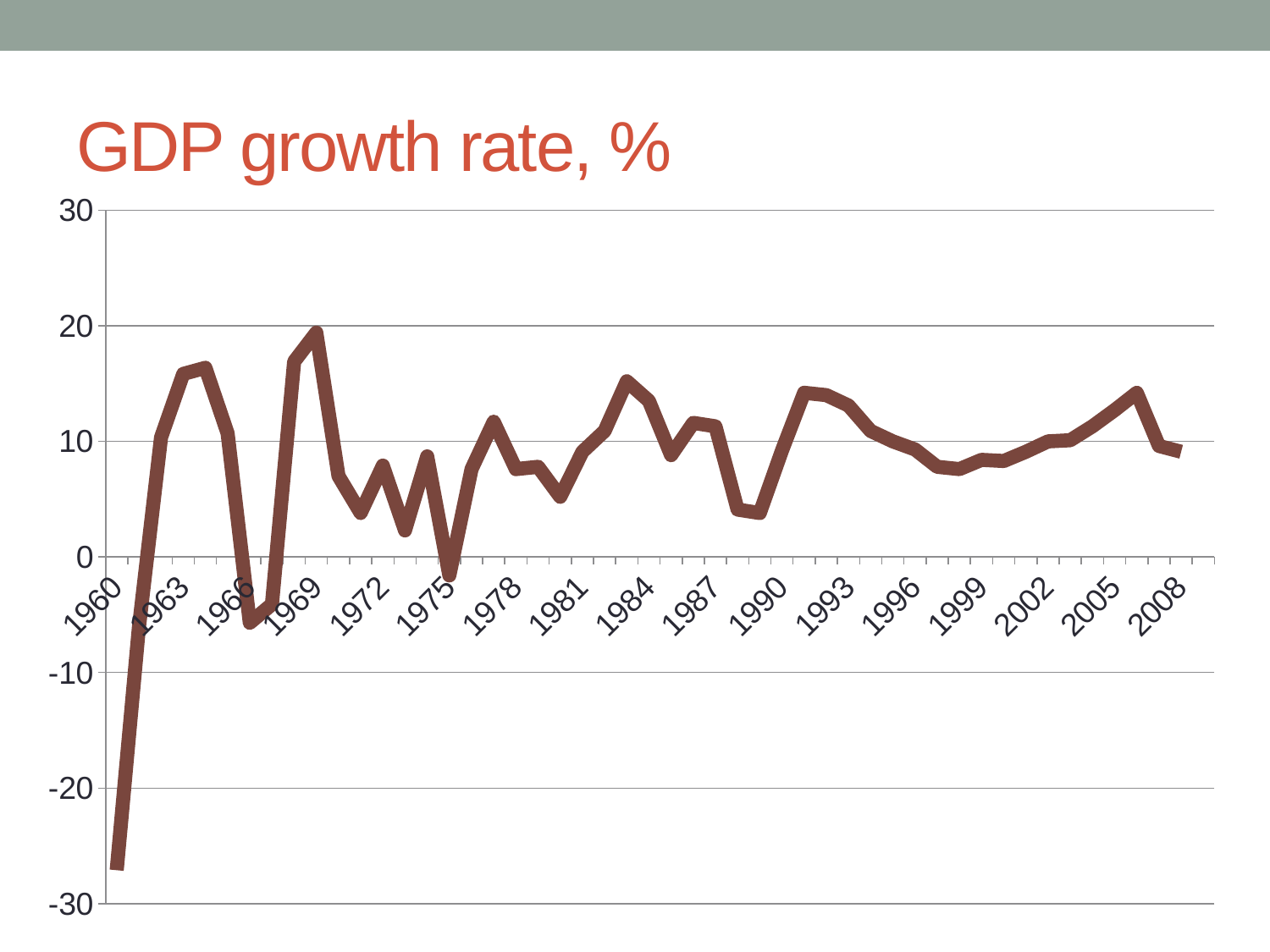
Does the GDP growth rate rise or fall between 1960 and 1963? rise What is the title of the chart? GDP growth rate, % Is the value for 1984 greater or less than 10? greater Is the value for 1969 greater or less than 10? greater Which year has the lowest GDP growth rate on the chart? 1960 What are the lowest and highest values shown on the vertical axis? -30 and 30 Is the value for 1972 greater or less than 10? less Which is larger, the value for 1960 or the value for 1969? 1969 What kind of chart is shown on the slide? line chart